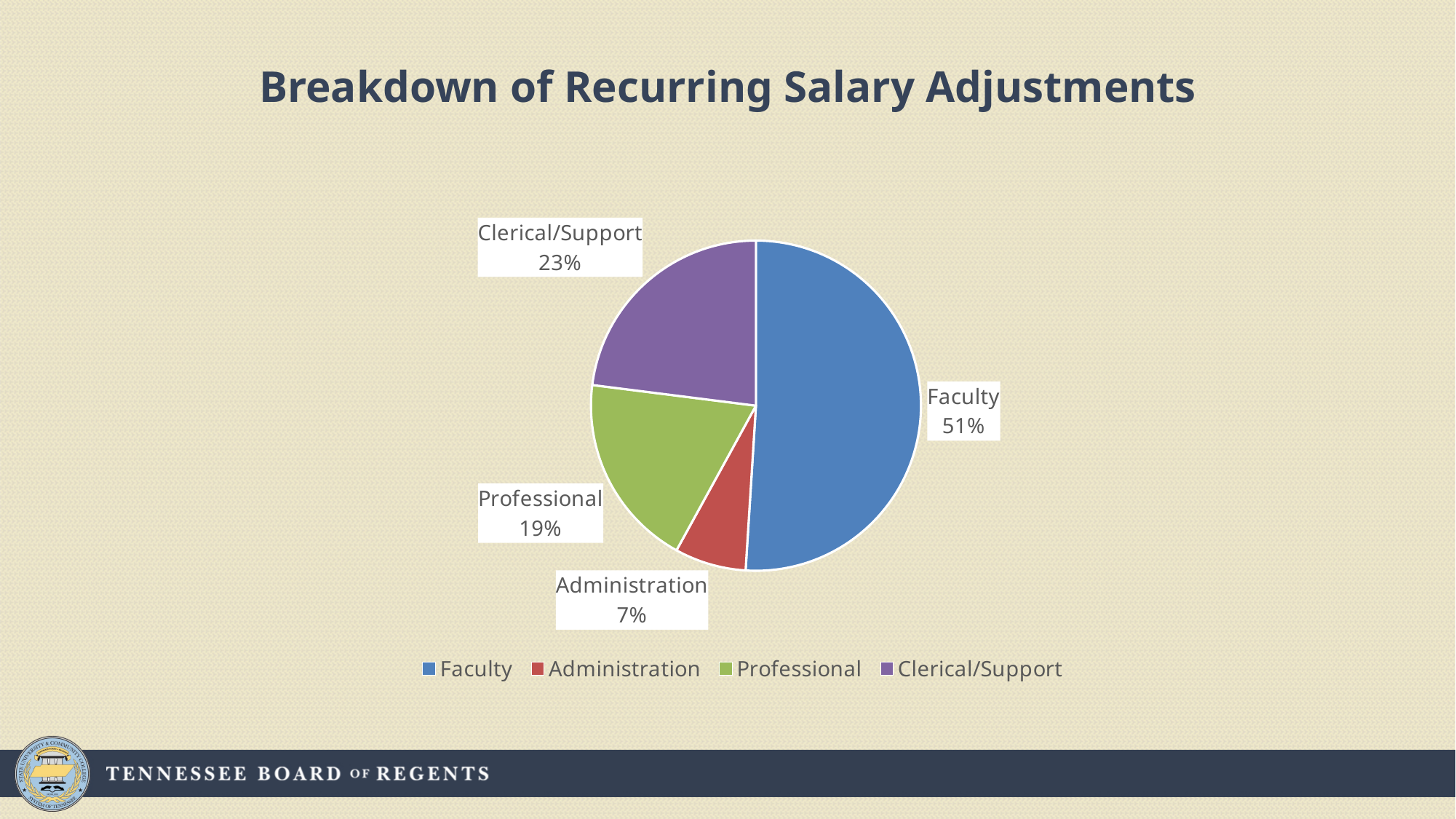
Which colour represents Professional in the chart? green What is the title of the chart? Breakdown of Recurring Salary Adjustments What is the difference in percentage points between the Clerical/Support and Professional shares? 4 What kind of chart is shown on the slide? pie chart What share of recurring salary adjustments goes to Faculty? 51% What share of recurring salary adjustments goes to Professional? 19% Which category has the largest share of the pie? Faculty What share of recurring salary adjustments goes to Administration? 7% Which category has the smallest share of the pie? Administration What share of recurring salary adjustments goes to Clerical/Support? 23% Which is larger, the Professional share or the Clerical/Support share? Clerical/Support How many categories are shown in the pie chart? 4